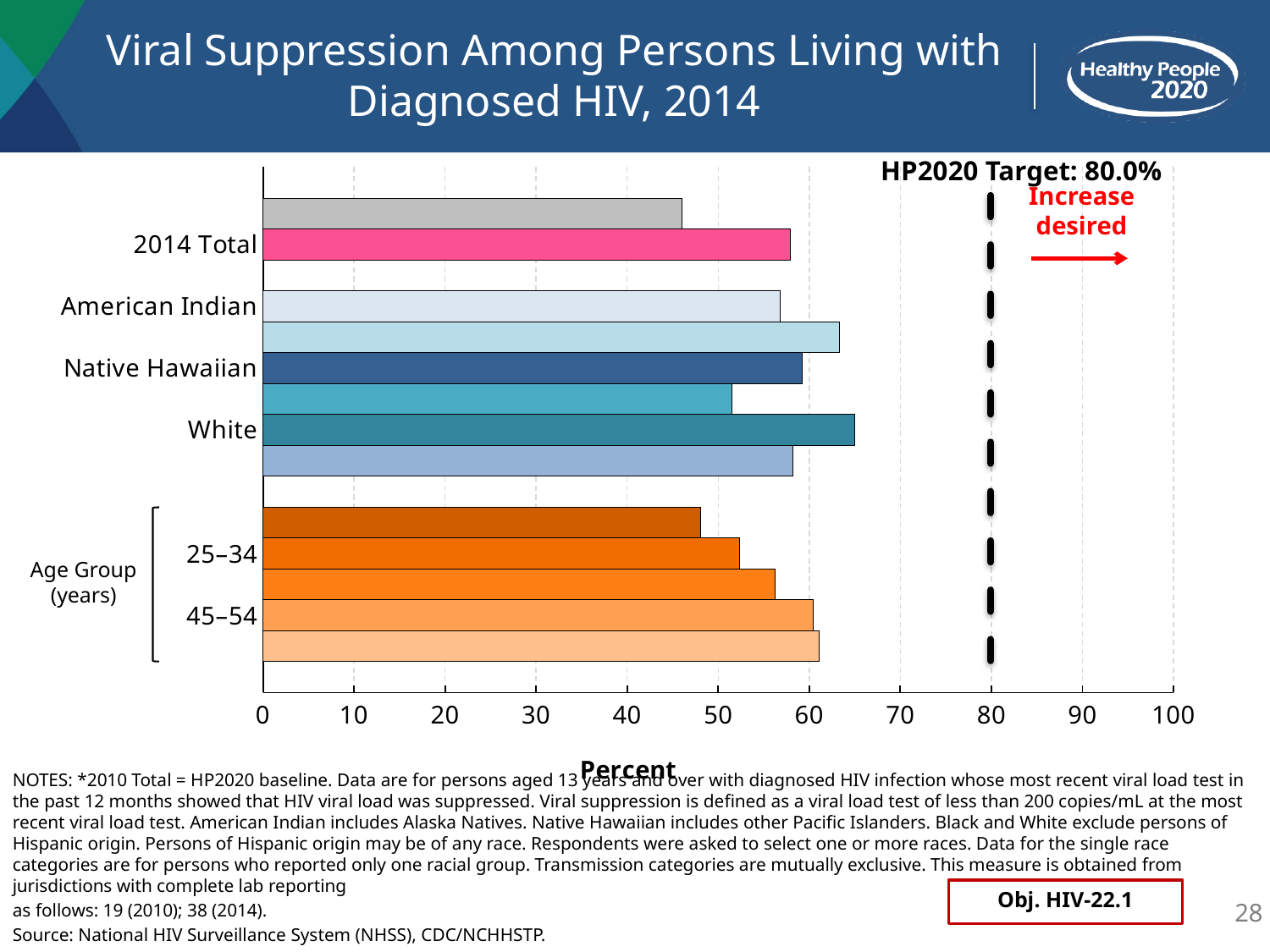
What is the label of the x axis? Percent Is the value for American Indian greater or less than 60? less Is the value for 2014 Total greater or less than 50? greater Is the value for White greater or less than the HP2020 target of 80? less Which is larger, the value for the 45–54 age group or the 25–34 age group? 45–54 What is the HP2020 target shown on the chart? 80.0% Which of the labeled categories has the longest bar? White Which is larger, the value for White or the value for 2014 Total? White What kind of chart is shown on the slide? bar chart